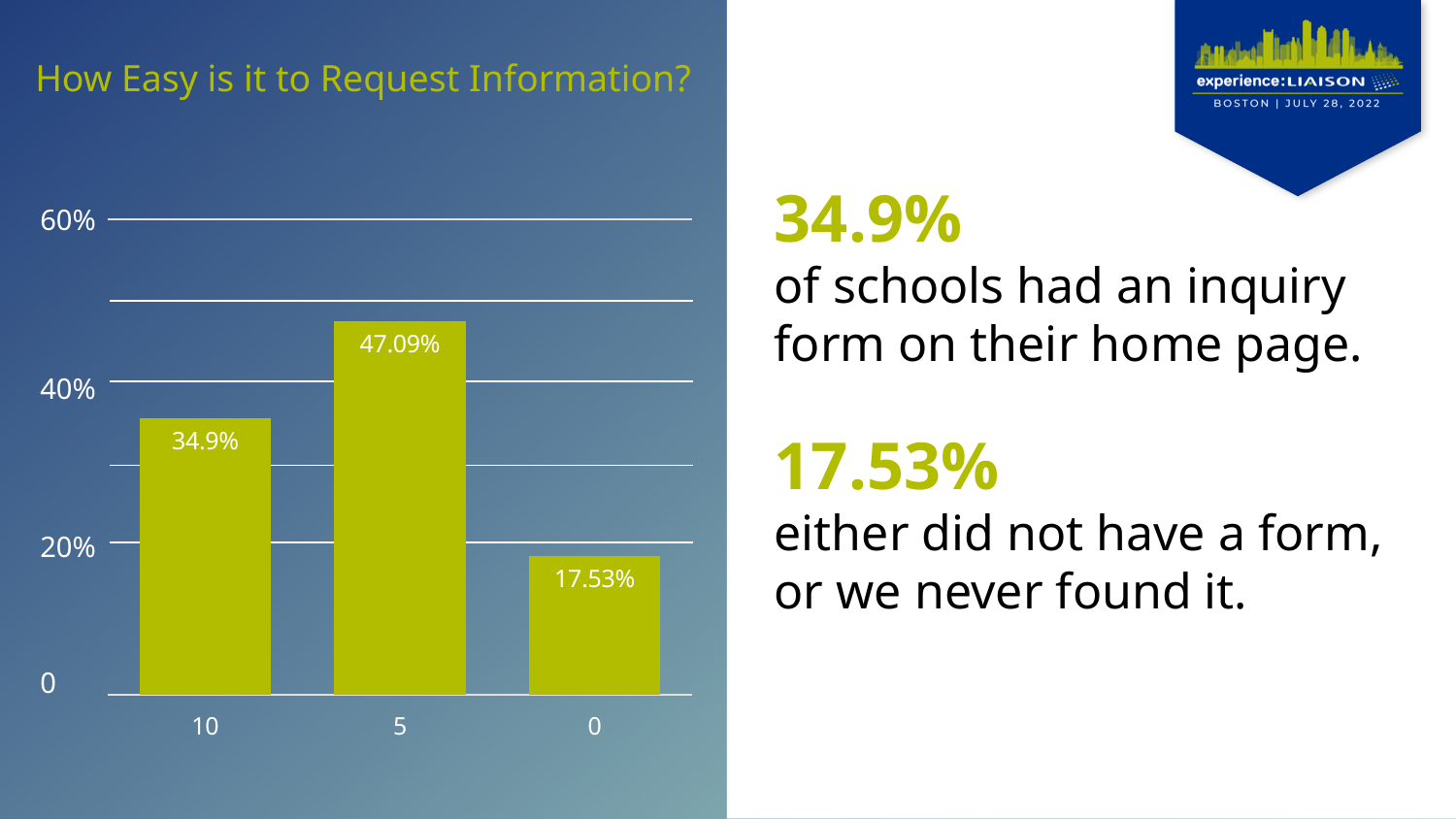
What kind of chart is shown on the slide? bar chart Which is larger, the value for category 10 or the value for category 0? 10 What is the value for category 10? 34.9% What is the value for category 0? 17.53% How many categories are shown on the x axis? 3 Is the value for category 5 greater or less than 40%? greater What is the difference between the values for category 5 and category 10? 12.19% What is the title of the chart? How Easy is it to Request Information? Which category has the lowest value? 0 What is the value for category 5? 47.09% What is the difference between the values for category 10 and category 0? 17.37% Which category has the highest value? 5